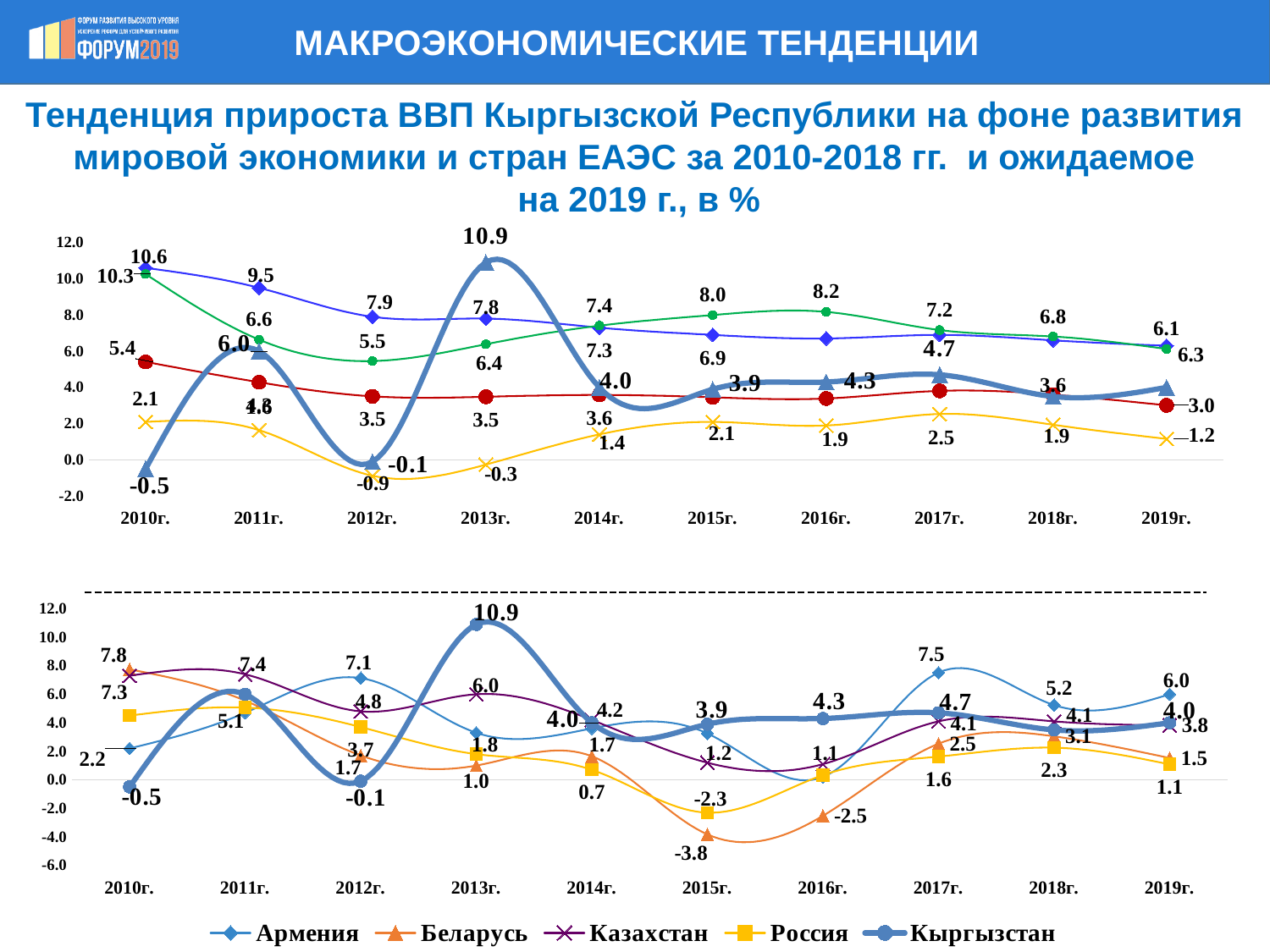
In the bottom chart, what is the value for Кыргызстан in 2013г.? 10.9 In the bottom chart, which series has the lowest value in 2015г.? Беларусь In the bottom chart, what is the difference between the values for Армения and Беларусь in 2019г.? 4.5 In the bottom chart, which is larger in 2017г.: the value for Казахстан or the value for Россия? Казахстан In the bottom chart, what is the value for Россия in 2014г.? 0.7 In the bottom chart, is the value for Армения in 2013г. greater or less than 2.0? greater How many series does the legend of the bottom chart list? 5 How many years are shown on the x axis of the top chart? 10 In the bottom chart, which series has the highest value in 2019г.? Армения In the bottom chart, what is the value for Беларусь in 2015г.? -3.8 What kind of chart is the bottom chart? line chart In the bottom chart, what is the value for Армения in 2017г.? 7.5